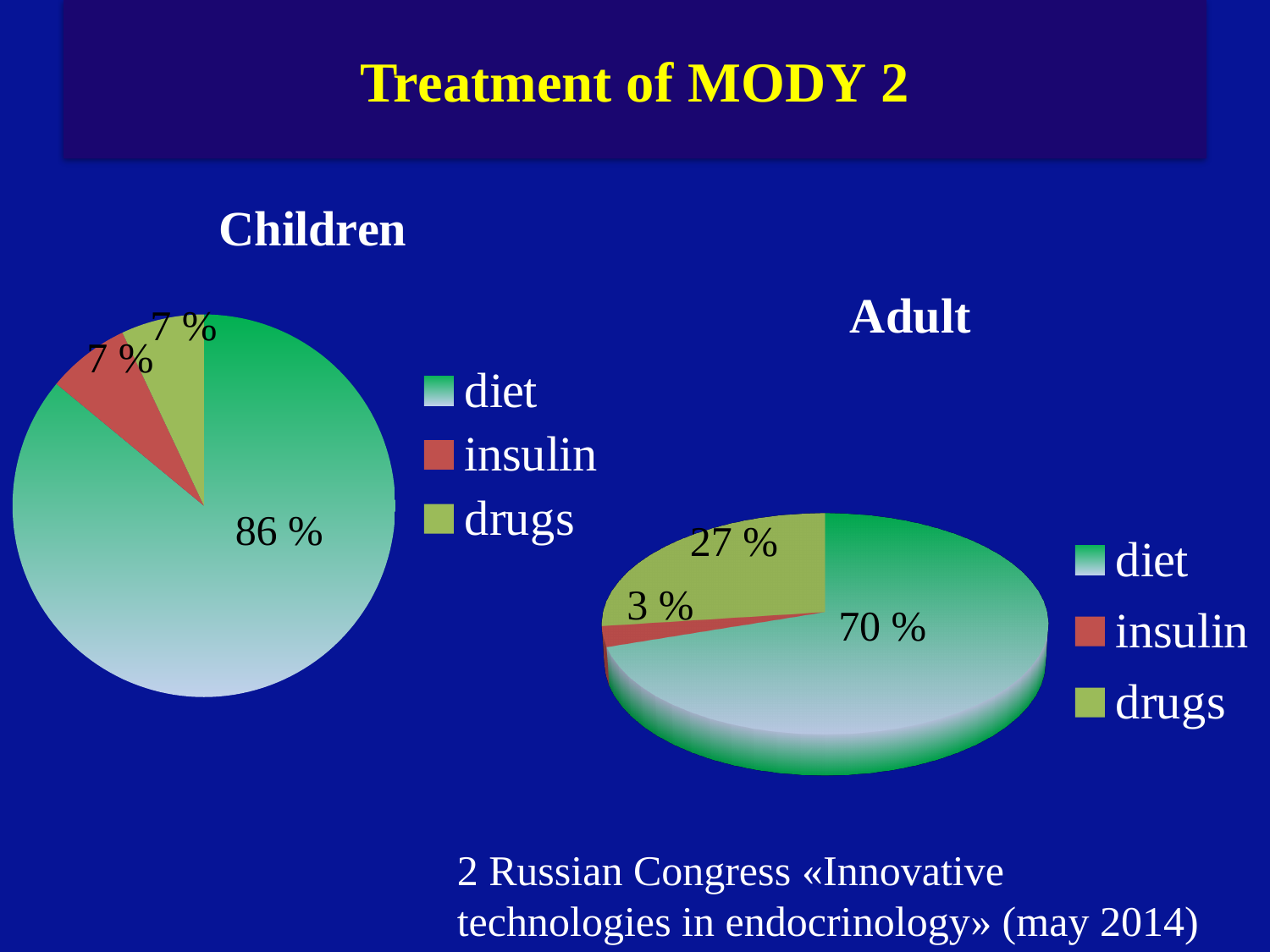
In the Adult pie chart, which treatment has the largest share? diet How many categories does the Children pie chart show? 3 In the Children pie chart, what share is insulin? 7 % In the Adult pie chart, what share is diet? 70 % What is the difference between the diet share in the Children chart and the diet share in the Adult chart? 16 % What type of chart is used for the Adult data? pie chart In the Adult pie chart, which is larger, the share for drugs or the share for insulin? drugs In the Adult pie chart, what share is drugs? 27 % In the Adult pie chart, what share is insulin? 3 % In the Children pie chart, what share is diet? 86 % In the Children pie chart, which treatment has the largest share? diet In the Adult pie chart, which treatment has the smallest share? insulin